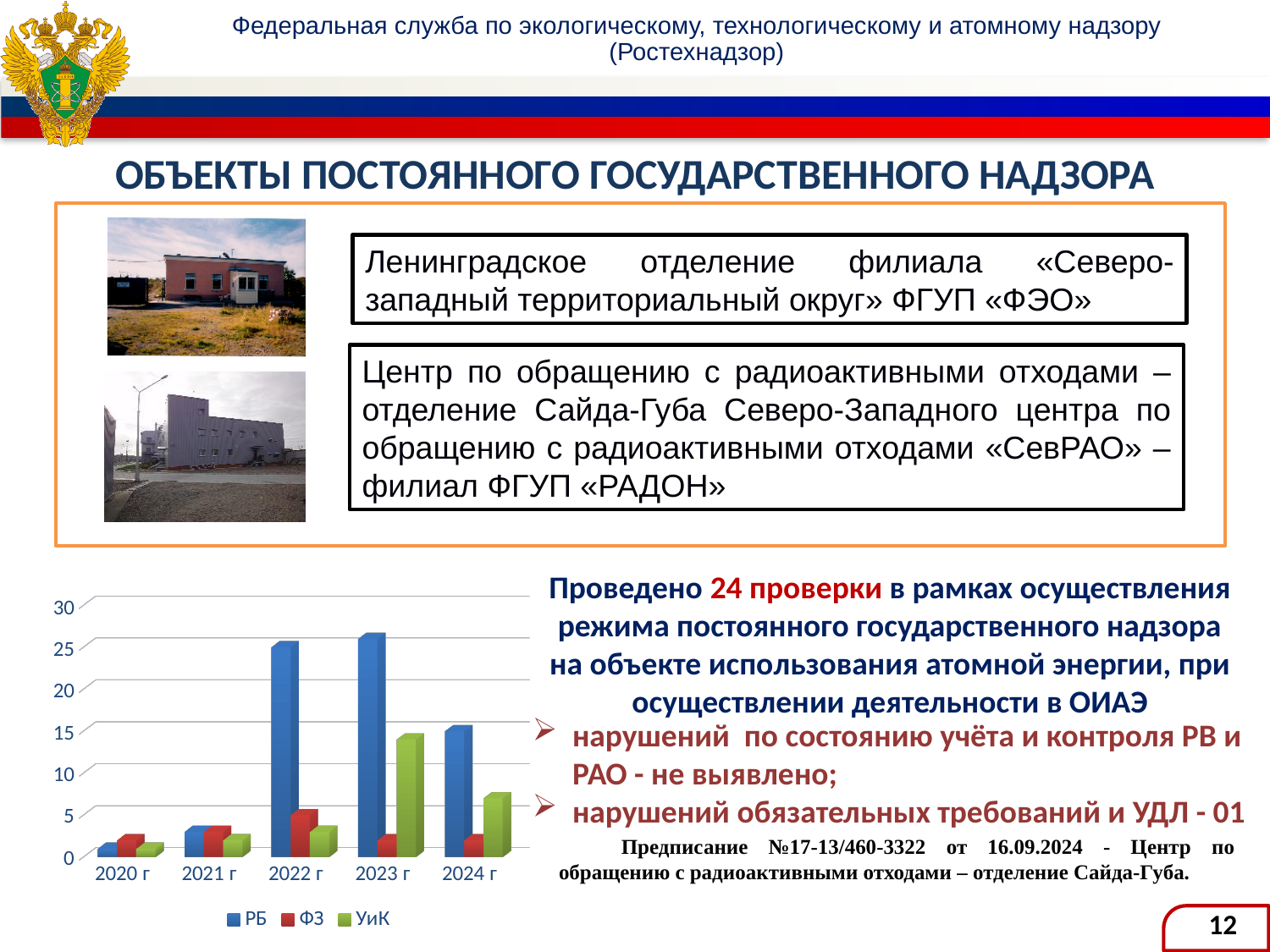
In 2024 г, which series has the larger value, ФЗ or УиК? УиК Is the value for РБ in 2024 г greater or less than 10? greater Is the value for УиК in 2023 г greater or less than 10? greater Which year has the highest value for the УиК series? 2023 г In 2023 г, which series has the larger value, РБ or УиК? РБ What kind of chart is shown at the bottom left of the slide? bar chart How many years (categories) are shown on the x axis of the chart? 5 How many series does the chart legend list? 3 Is the value for ФЗ in 2022 г greater or less than 10? less Which year has the lowest value for the РБ series? 2020 г What are the series names listed in the chart legend? РБ, ФЗ, УиК